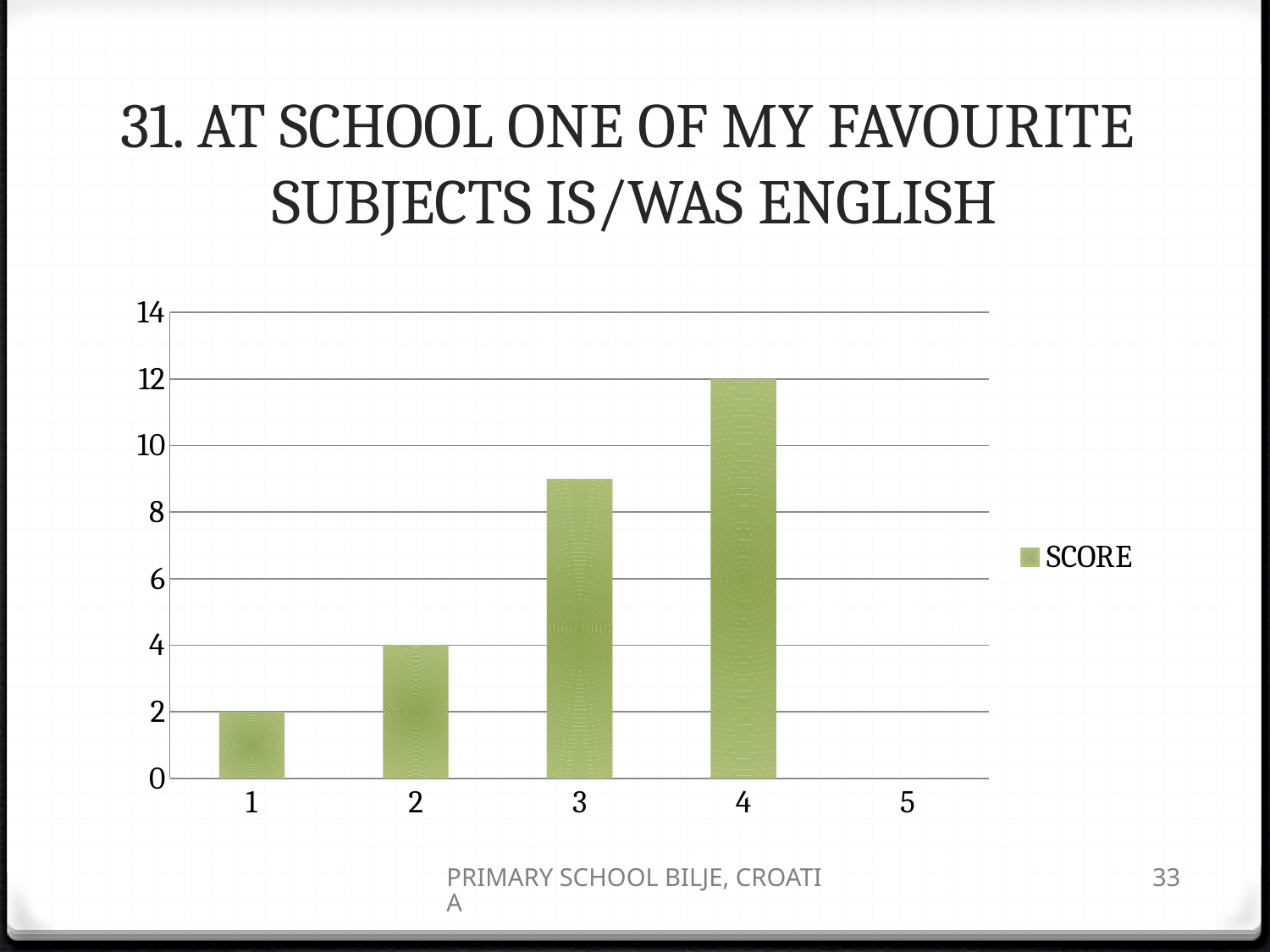
How many categories are shown on the x axis? 5 Is the value for category 3 greater or less than 8? greater Which is larger, the value for category 2 or the value for category 3? category 3 Is the value for category 3 greater or less than 10? less What is the difference between the values for category 4 and category 2? 8 How many series does the legend list? 1 What is the value for category 2? 4 What type of chart is shown on the slide? bar chart What is the value for category 1? 2 What is the name of the series shown in the legend? SCORE Which category has the highest value? 4 What is the value for category 4? 12